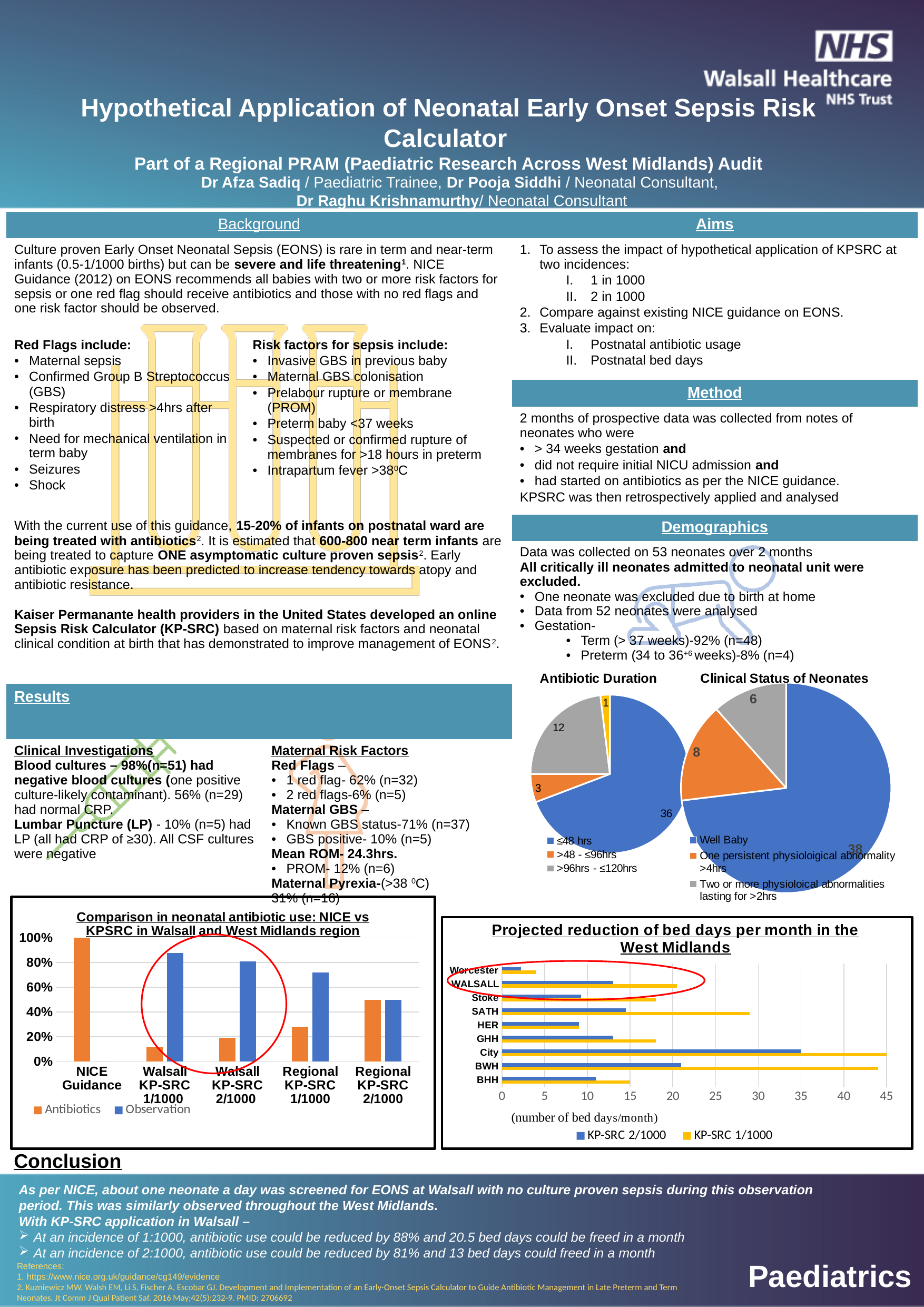
In the Clinical Status of Neonates pie chart, what is the difference between the Well Baby count and the count with one persistent physiological abnormality >4hrs? 30 In the 'Comparison in neonatal antibiotic use' chart, how many series does the legend list? 2 In the 'Projected reduction of bed days per month in the West Midlands' chart, how many hospitals/categories are shown? 9 In the 'Comparison in neonatal antibiotic use' chart, which is larger for Regional KP-SRC 1/1000: Antibiotics or Observation? Observation In the 'Comparison in neonatal antibiotic use' chart, is the Observation value for Walsall KP-SRC 1/1000 greater or less than 80%? greater In the Clinical Status of Neonates pie chart, what is the total number of neonates across all three slices? 52 In the Clinical Status of Neonates pie chart, how many neonates were classed as Well Baby? 38 In the 'Projected reduction of bed days per month in the West Midlands' chart, which category has the highest KP-SRC 1/1000 value? City In the Antibiotic Duration pie chart, how many neonates are in the >96hrs - ≤120hrs category? 12 What type of chart is 'Comparison in neonatal antibiotic use: NICE vs KPSRC in Walsall and West Midlands region'? bar chart In the Antibiotic Duration pie chart, how many neonates received antibiotics for ≤48 hrs? 36